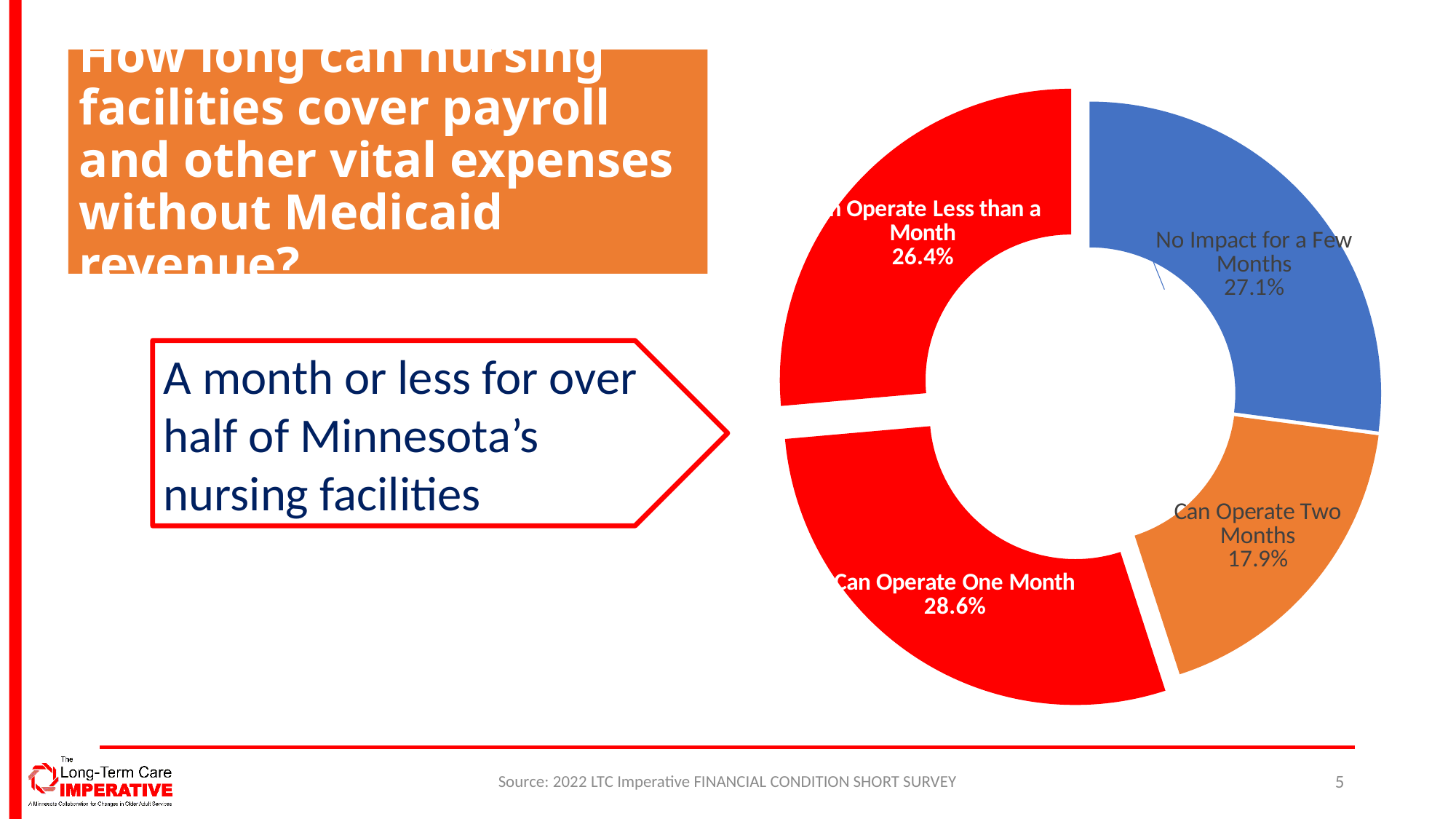
What percentage of nursing facilities can operate two months? 17.9% What percentage of nursing facilities can operate less than a month? 26.4% What is the difference in percentage points between 'Can Operate One Month' and 'Can Operate Two Months'? 10.7 percentage points Which category has the largest share of the chart? Can Operate One Month What is the combined share of facilities that can operate a month or less ('Can Operate Less than a Month' plus 'Can Operate One Month')? 55.0% What colour are the 'Can Operate Less than a Month' and 'Can Operate One Month' slices? red How many categories (slices) does the chart show? 4 What percentage of nursing facilities report no impact for a few months? 27.1% What kind of chart is shown on the slide? doughnut chart Which category has the smallest share of the chart? Can Operate Two Months Which is larger: the share for 'No Impact for a Few Months' or the share for 'Can Operate Less than a Month'? No Impact for a Few Months What percentage of nursing facilities can operate one month? 28.6%